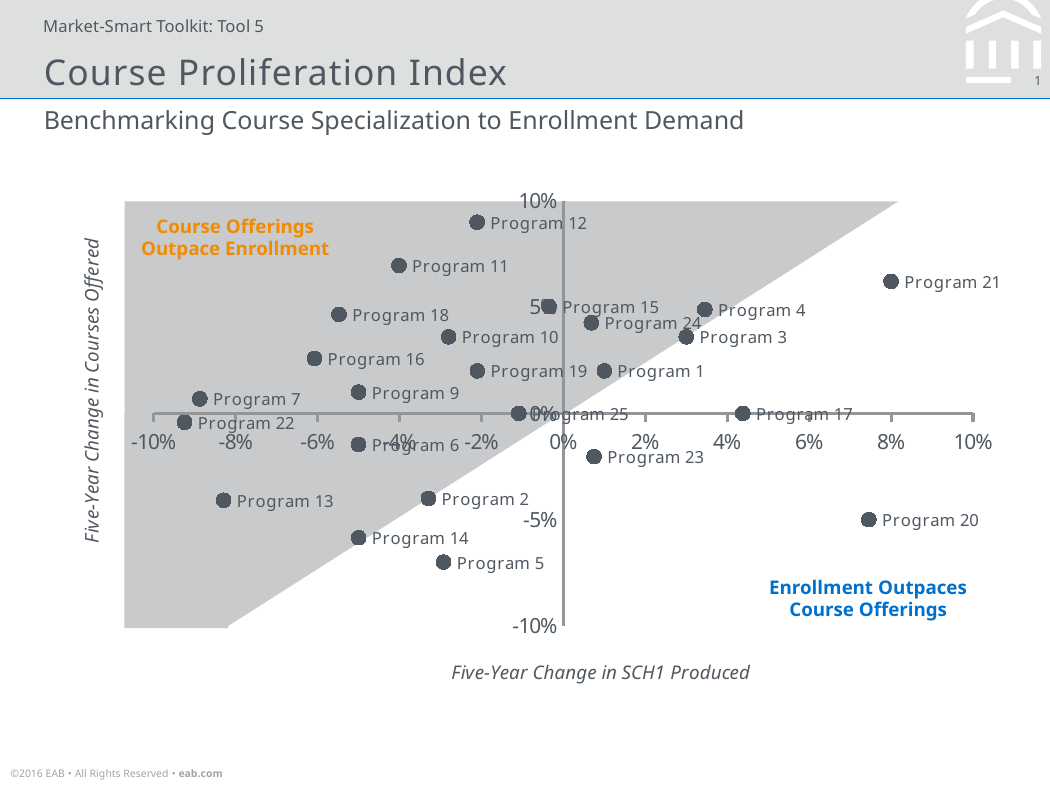
Is the five-year change in courses offered for Program 12 greater or less than 5%? greater Is the five-year change in SCH produced for Program 13 greater or less than -6%? less Which has a higher five-year change in SCH produced, Program 21 or Program 7? Program 21 What label appears in the shaded region in the upper left of the chart? Course Offerings Outpace Enrollment Is the five-year change in SCH produced for Program 7 greater or less than -8%? less What is the title of the horizontal axis? Five-Year Change in SCH1 Produced Which program has the lowest five-year change in courses offered? Program 5 Which program has the highest five-year change in courses offered? Program 12 Which has a higher five-year change in courses offered, Program 12 or Program 11? Program 12 What kind of chart is shown on the slide? Scatter chart